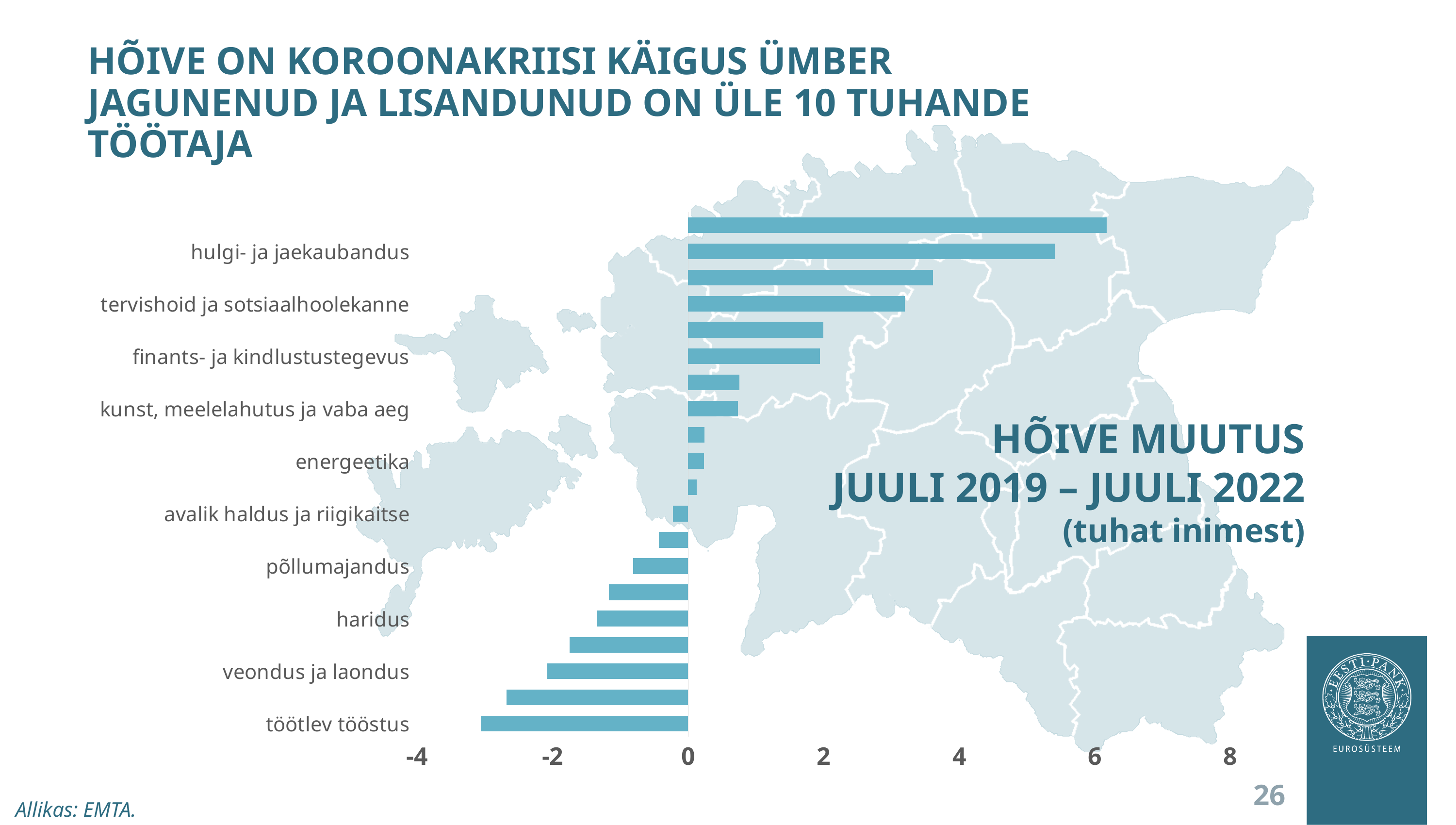
Is the value for töötlev tööstus greater or less than -2? less Is the value for finants- ja kindlustustegevus greater or less than 1? greater Is the value for põllumajandus greater or less than 0? less In what unit are the chart's values expressed, according to the subtitle? tuhat inimest What kind of chart is shown on the slide? bar chart Which has the larger value, hulgi- ja jaekaubandus or tervishoid ja sotsiaalhoolekanne? hulgi- ja jaekaubandus How many bars are plotted in the chart? 20 What is the title of the chart? HÕIVE MUUTUS JUULI 2019 – JUULI 2022 Which has the larger value, haridus or töötlev tööstus? haridus